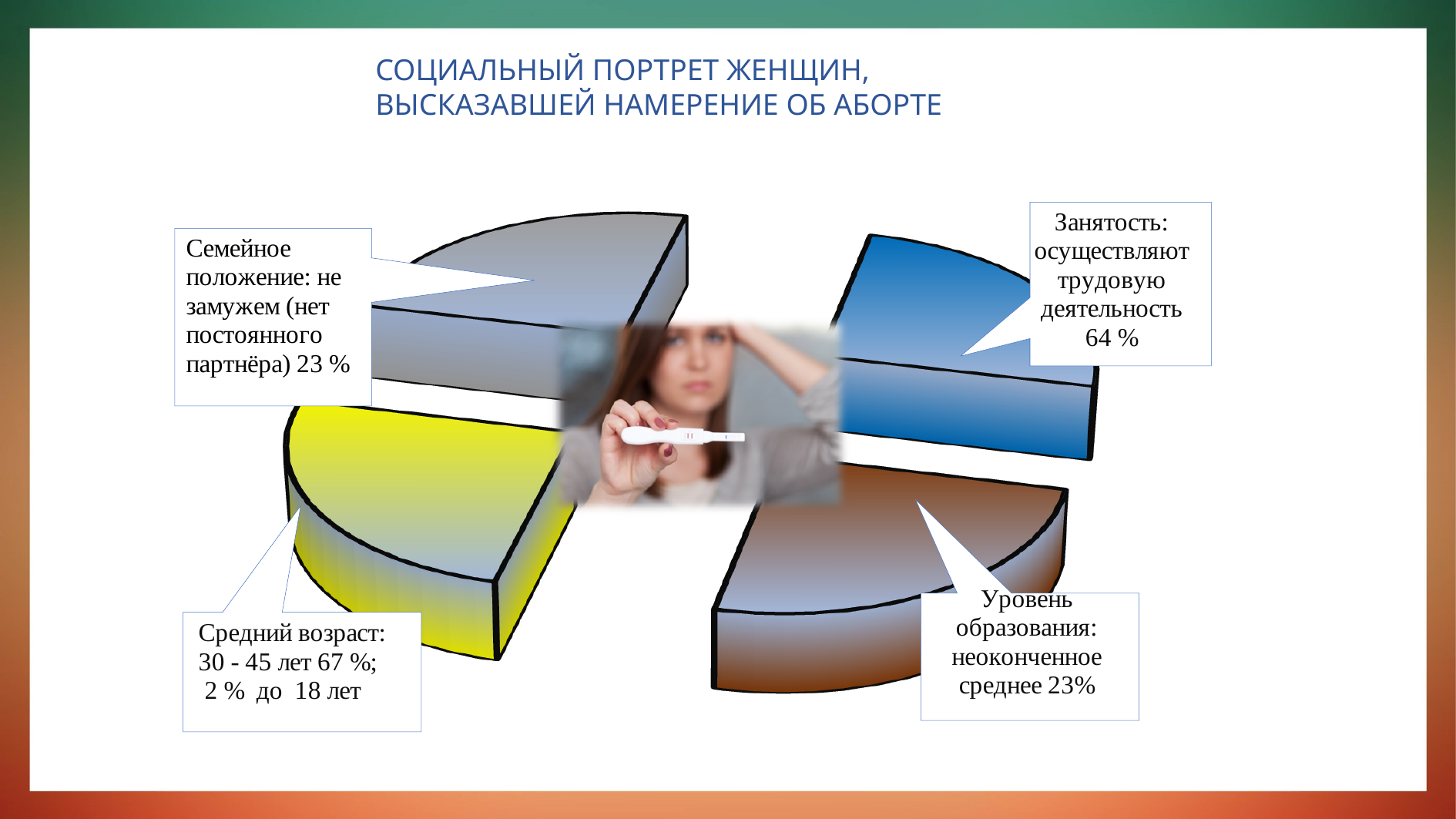
What percentage of women are aged 30–45 according to the callout 'Средний возраст'? 67 % What kind of chart is shown on the slide? pie chart What colour is the pie slice that the average age (Средний возраст) callout points to? yellow What percentage is given in the callout for employment (Занятость: осуществляют трудовую деятельность)? 64 % What colour is the pie slice that the employment (Занятость) callout points to? blue What percentage is given for incomplete secondary education (неоконченное среднее) in the callout 'Уровень образования'? 23% What percentage of women are reported as not married (no permanent partner) in the callout 'Семейное положение'? 23 % Which callout value is larger: employment (64 %) or not married (23 %)? employment (64 %) What is the difference between the employment percentage (64 %) and the not-married percentage (23 %)? 41 % How many slices does the pie chart have? 4 What percentage of women are under 18 according to the callout 'Средний возраст'? 2 % What is the difference between the share aged 30–45 (67 %) and the share under 18 (2 %)? 65 %